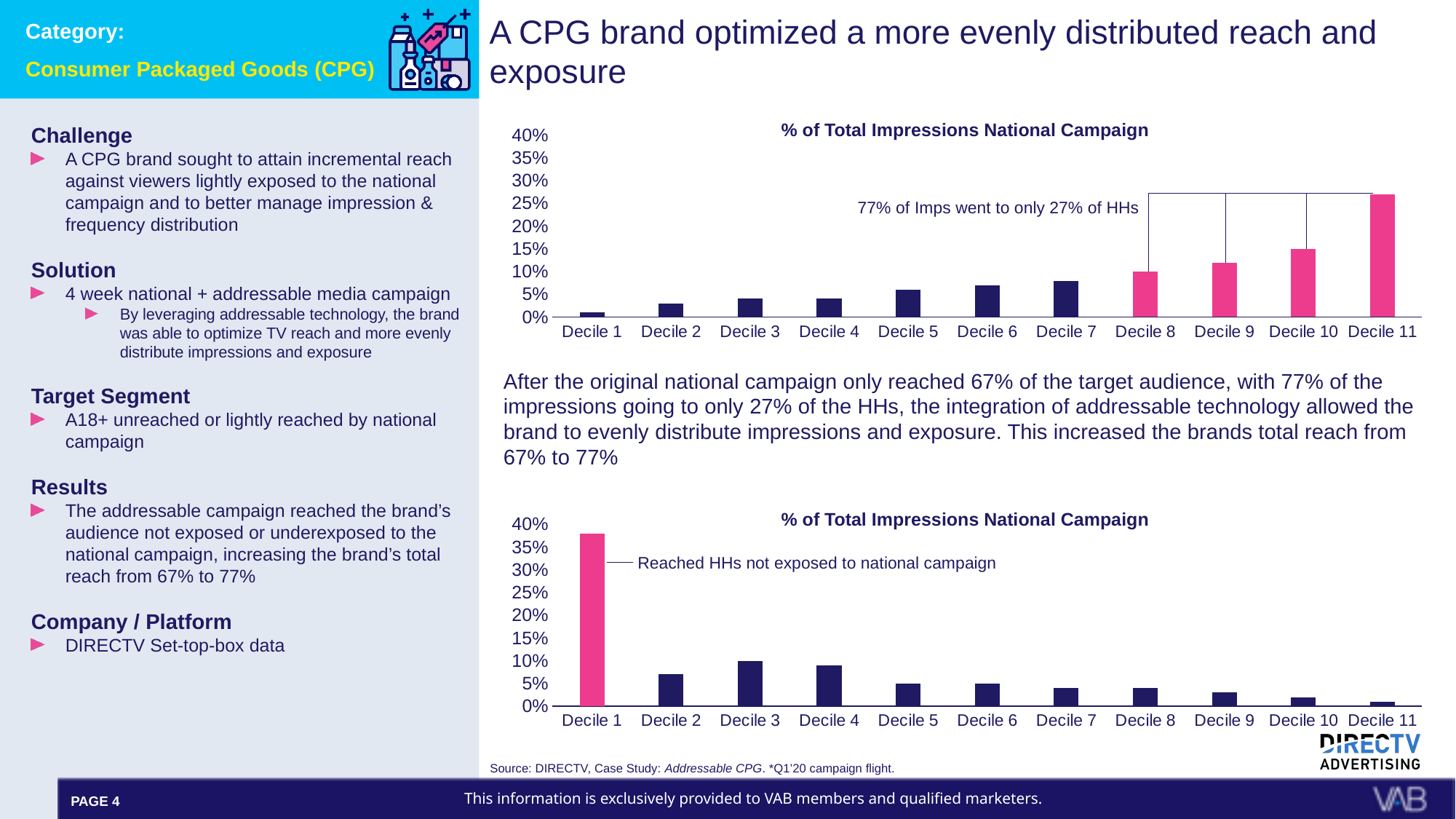
In the top chart, which decile has the highest share of total impressions? Decile 11 How many deciles are shown on the x axis of the top chart? 11 In the bottom chart, which decile has the highest share of total impressions? Decile 1 In the top chart, is the value for Decile 11 greater or less than 25%? greater In the bottom chart, which decile has the lowest share of total impressions? Decile 11 In the bottom chart, which is larger, the value for Decile 3 or the value for Decile 9? Decile 3 In the top chart, do the values generally rise or fall from Decile 1 to Decile 11? Rise In the top chart, which decile has the lowest share of total impressions? Decile 1 What kind of chart is the top chart on the slide? Bar chart In the bottom chart, is the value for Decile 1 greater or less than 35%? greater In the top chart, is the value for Decile 10 greater or less than 20%? less What annotation text is shown above the pink bars in the top chart? 77% of Imps went to only 27% of HHs